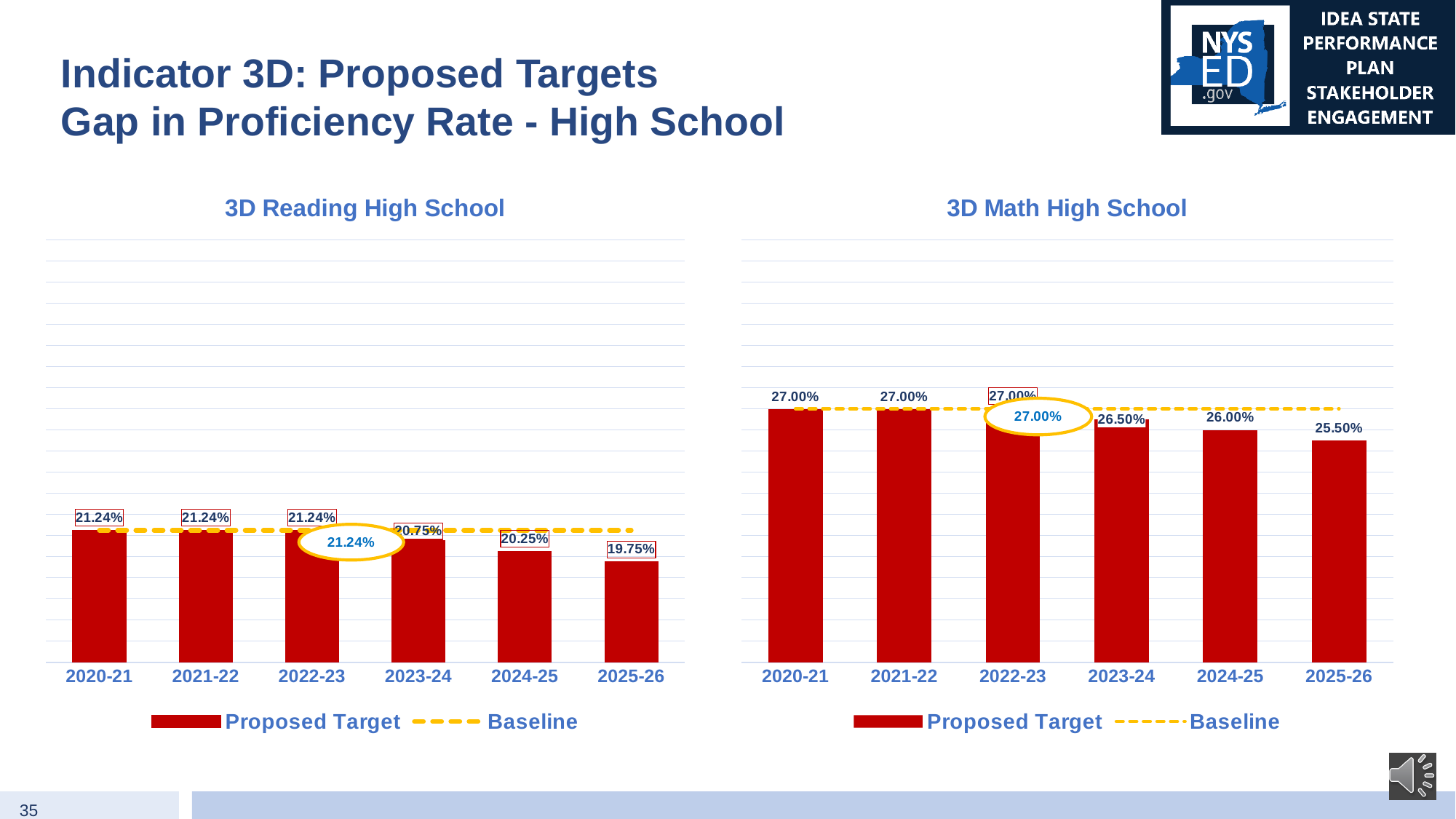
In the 3D Reading High School chart, which year has the lowest proposed target? 2025-26 How many years are shown on the x axis of the 3D Reading High School chart? 6 In the 3D Math High School chart, is the proposed target for 2024-25 larger or smaller than the one for 2025-26? larger What kind of chart is the 3D Reading High School chart? combination bar and line chart How many series does the legend of the 3D Math High School chart list? 2 In the 3D Math High School chart, which year has the lowest proposed target? 2025-26 In the 3D Reading High School chart, what is the proposed target for 2025-26? 19.75% In the 3D Math High School chart, what is the baseline value shown in the circled label? 27.00% In the 3D Math High School chart, what is the difference between the proposed targets for 2022-23 and 2025-26? 1.50% In the 3D Reading High School chart, what is the proposed target for 2023-24? 20.75% In the 3D Math High School chart, what is the proposed target for 2023-24? 26.50% In the 3D Reading High School chart, what is the difference between the proposed targets for 2020-21 and 2025-26? 1.49%